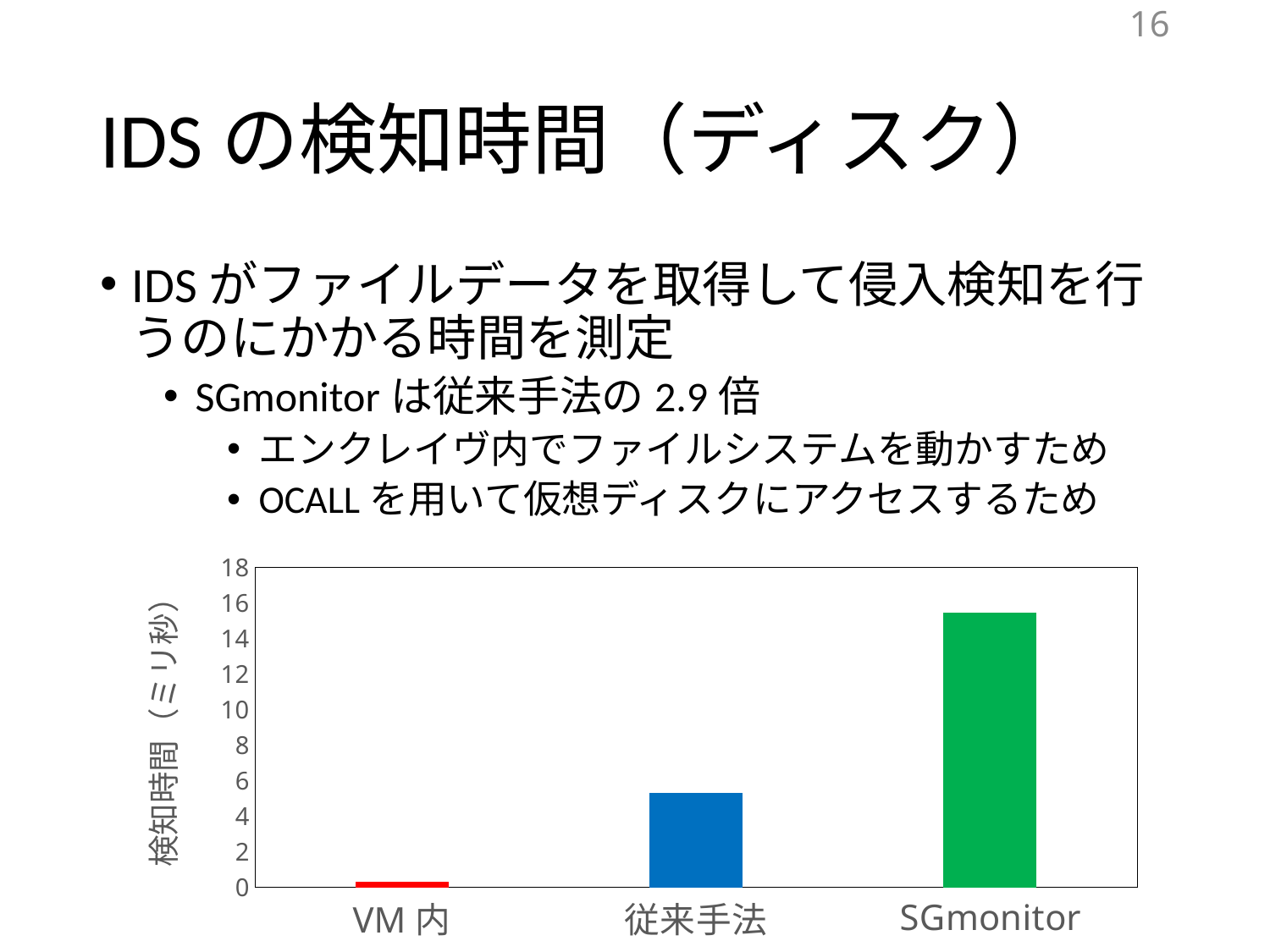
Which category has the highest detection time in the chart? SGmonitor Is the value for VM 内 greater or less than 2? less Do the bar values rise or fall from left to right along the x axis? rise How many categories are shown on the x axis of the chart? 3 Which has a larger value, VM 内 or 従来手法? 従来手法 What is the label of the vertical axis of the chart? 検知時間（ミリ秒） Which has a larger value, 従来手法 or SGmonitor? SGmonitor What kind of chart is shown on the slide? bar chart Is the value for 従来手法 greater or less than 4? greater Is the value for 従来手法 greater or less than 6? less Which category has the lowest detection time in the chart? VM 内